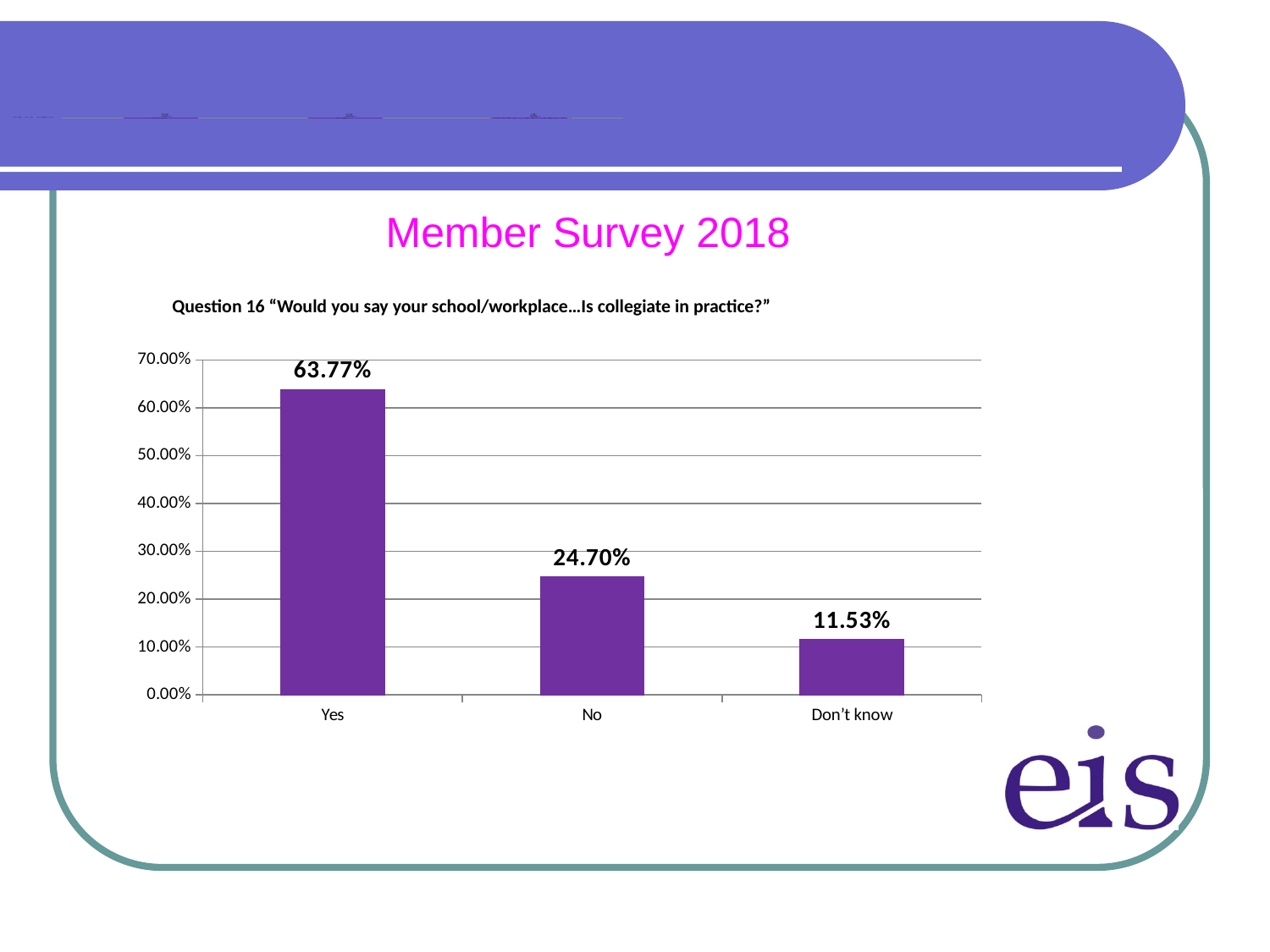
Is the value for "Yes" greater or less than 60.00%? greater What is the difference in percentage points between the "Yes" and "No" responses? 39.07% Which is larger, the value for "No" or the value for "Don't know"? No What is the difference in percentage points between the "No" and "Don't know" responses? 13.17% What percentage of respondents answered "No"? 24.70% Which response category has the lowest value? Don't know Which response category has the highest value? Yes What kind of chart is shown on the slide? Bar chart What percentage of respondents answered "Yes"? 63.77% What is the title of the chart? Question 16 "Would you say your school/workplace…Is collegiate in practice?" How many response categories are shown on the x axis? 3 What percentage of respondents answered "Don't know"? 11.53%